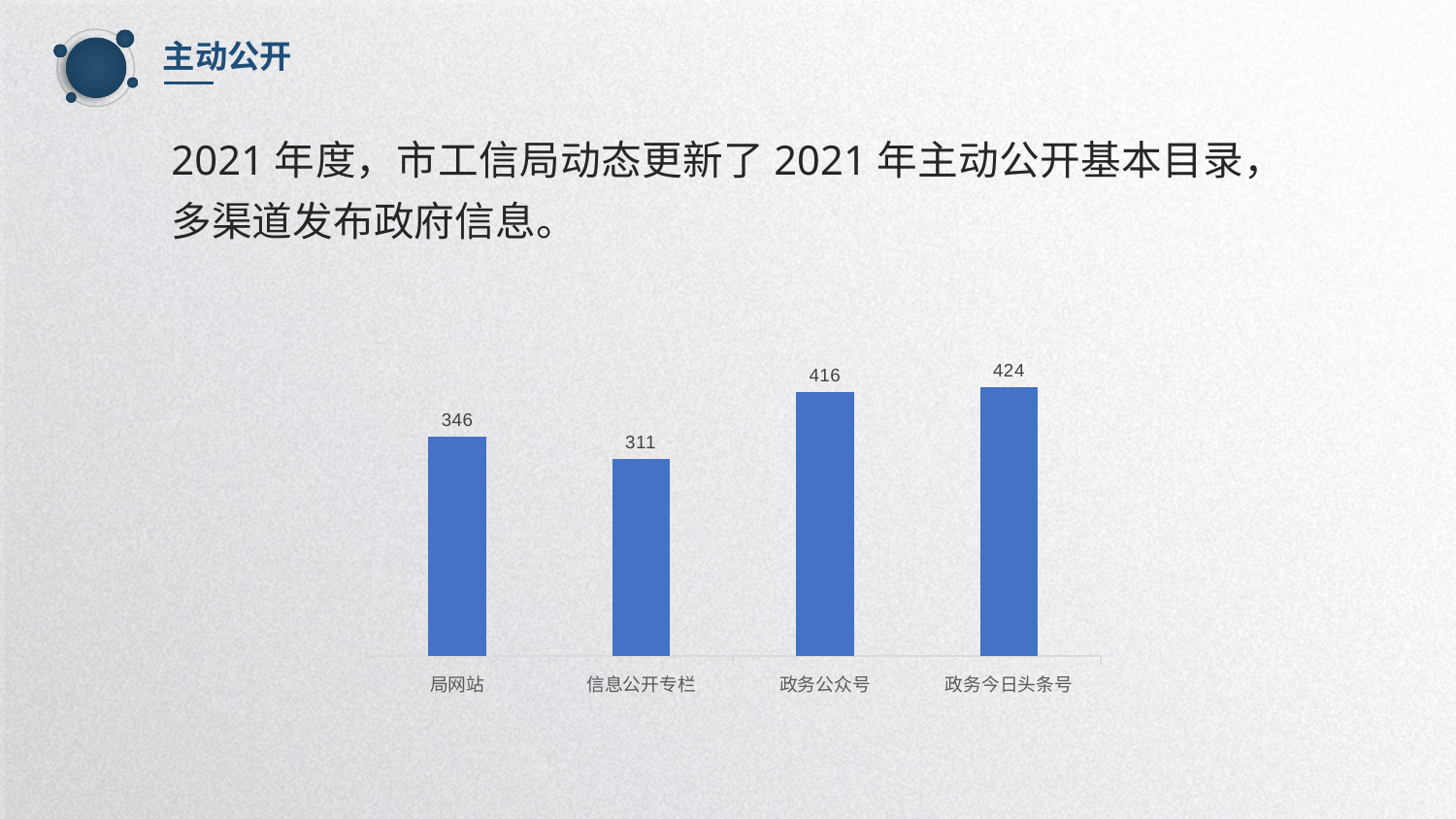
What kind of chart is shown on the slide? bar chart What is the difference between the values for 政务公众号 and 局网站? 70 How many categories are shown in the chart? 4 What colour are the bars in the chart? blue What is the value for 局网站? 346 Which category has the highest value? 政务今日头条号 Which category has the lowest value? 信息公开专栏 What is the value for 政务公众号? 416 Which is larger, the value for 局网站 or the value for 信息公开专栏? 局网站 What is the value for 信息公开专栏? 311 What is the value for 政务今日头条号? 424 What is the difference between the values for 政务今日头条号 and 信息公开专栏? 113